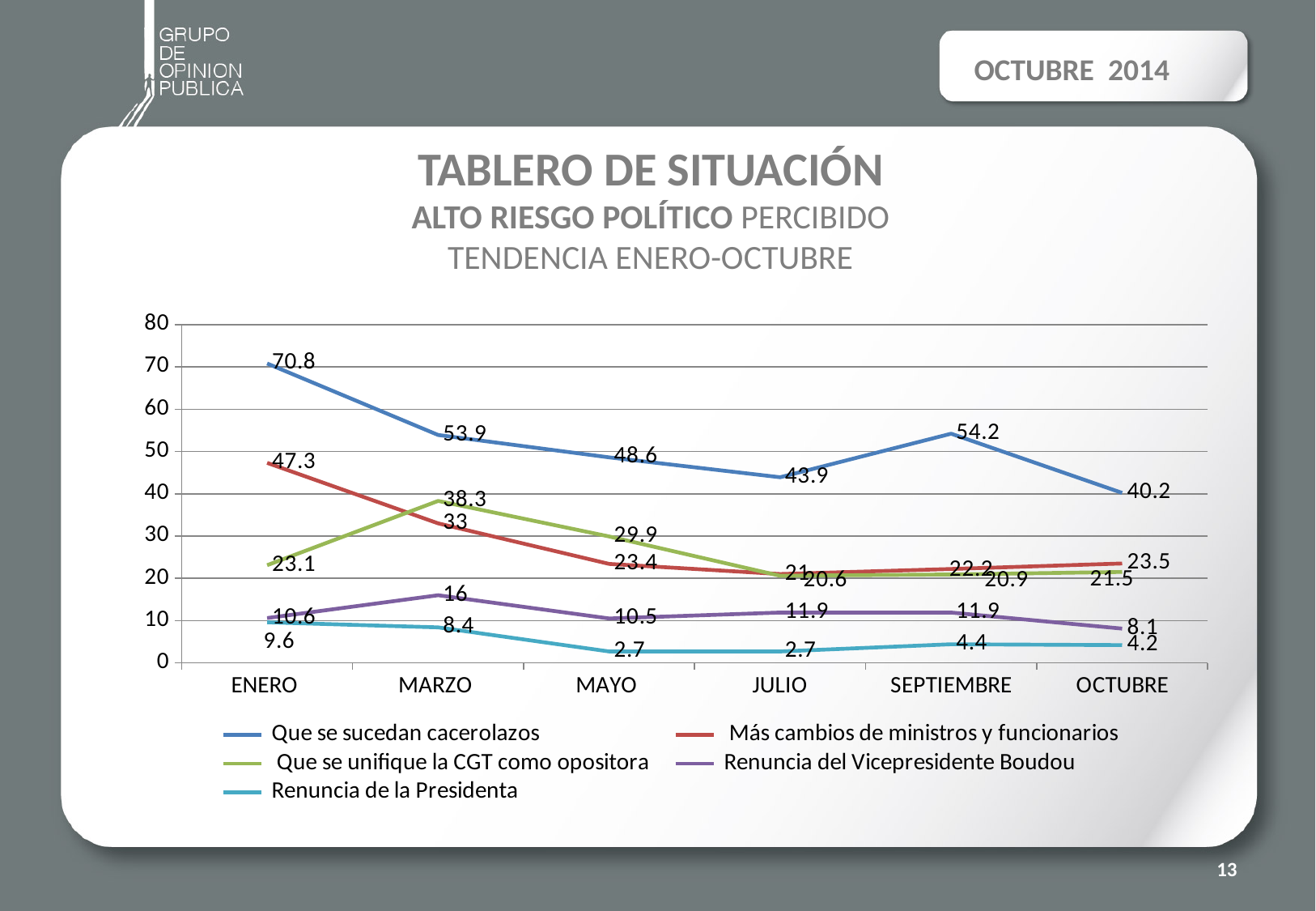
Is the value for "Que se sucedan cacerolazos" in SEPTIEMBRE greater or less than 50? greater Does the value for "Renuncia de la Presidenta" rise or fall from ENERO to MAYO? fall In which month is "Que se sucedan cacerolazos" lowest? OCTUBRE How many series does the legend list? 5 What is the value for "Que se sucedan cacerolazos" in ENERO? 70.8 How many months are shown on the x axis? 6 What is the value for "Que se sucedan cacerolazos" in OCTUBRE? 40.2 What is the difference between the ENERO and OCTUBRE values for "Que se sucedan cacerolazos"? 30.6 What is the value for "Renuncia del Vicepresidente Boudou" in MARZO? 16 What kind of chart is shown on the slide? line chart In which month is "Que se sucedan cacerolazos" highest? ENERO In MARZO, which is larger: "Que se unifique la CGT como opositora" or "Más cambios de ministros y funcionarios"? Que se unifique la CGT como opositora